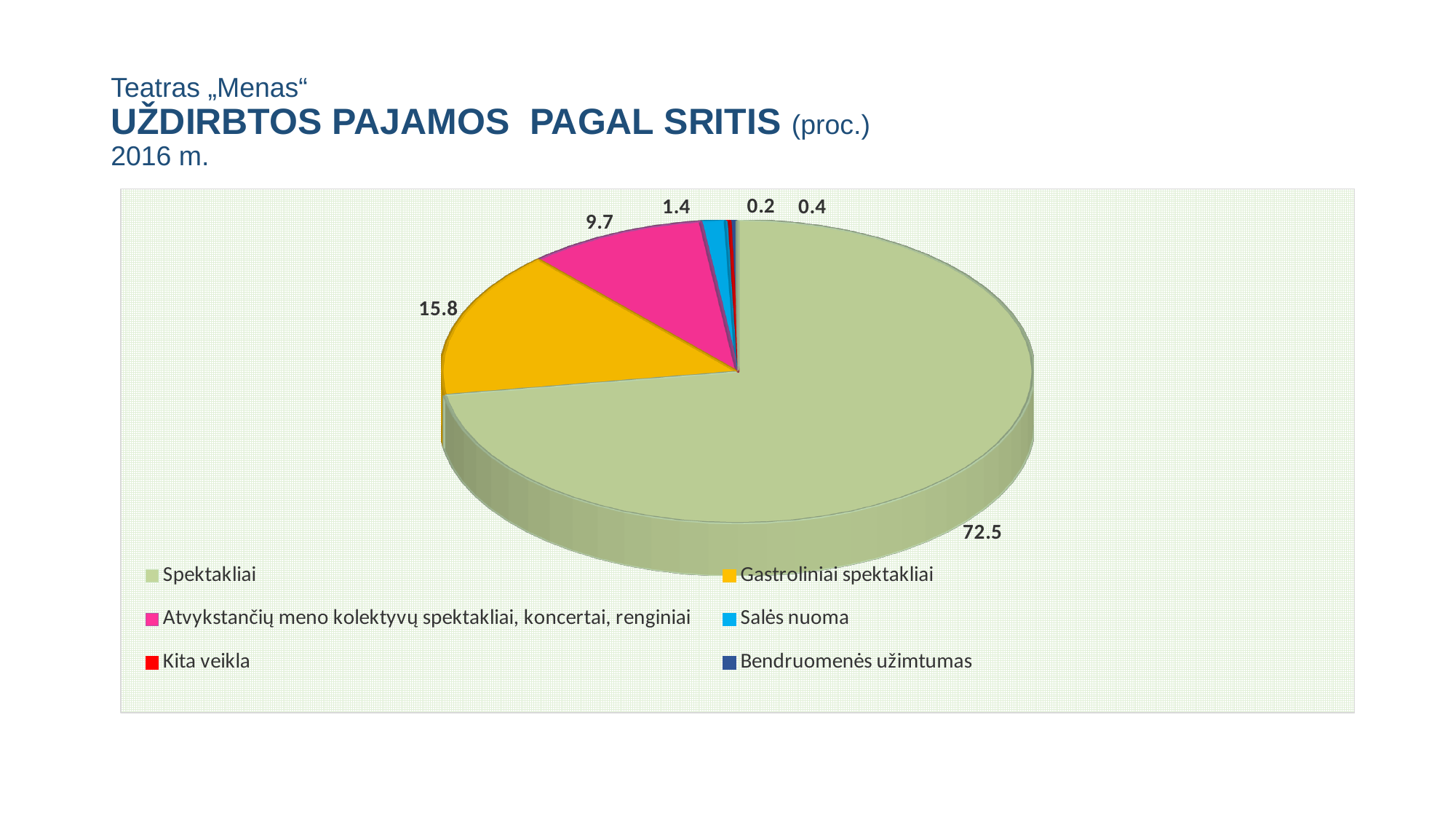
What kind of chart is shown on the slide? pie chart How many categories does the legend list? 6 What colour is the slice for Salės nuoma? light blue Which category has the largest slice of the pie? Spektakliai What is the value shown for Gastroliniai spektakliai? 15.8 What is the value shown for Kita veikla? 0.2 What is the value shown for Spektakliai? 72.5 What is the value shown for Atvykstančių meno kolektyvų spektakliai, koncertai, renginiai? 9.7 What is the difference between the values for Gastroliniai spektakliai and Atvykstančių meno kolektyvų spektakliai, koncertai, renginiai? 6.1 What is the value shown for Salės nuoma? 1.4 Which category has the smallest slice of the pie? Kita veikla What is the value shown for Bendruomenės užimtumas? 0.4